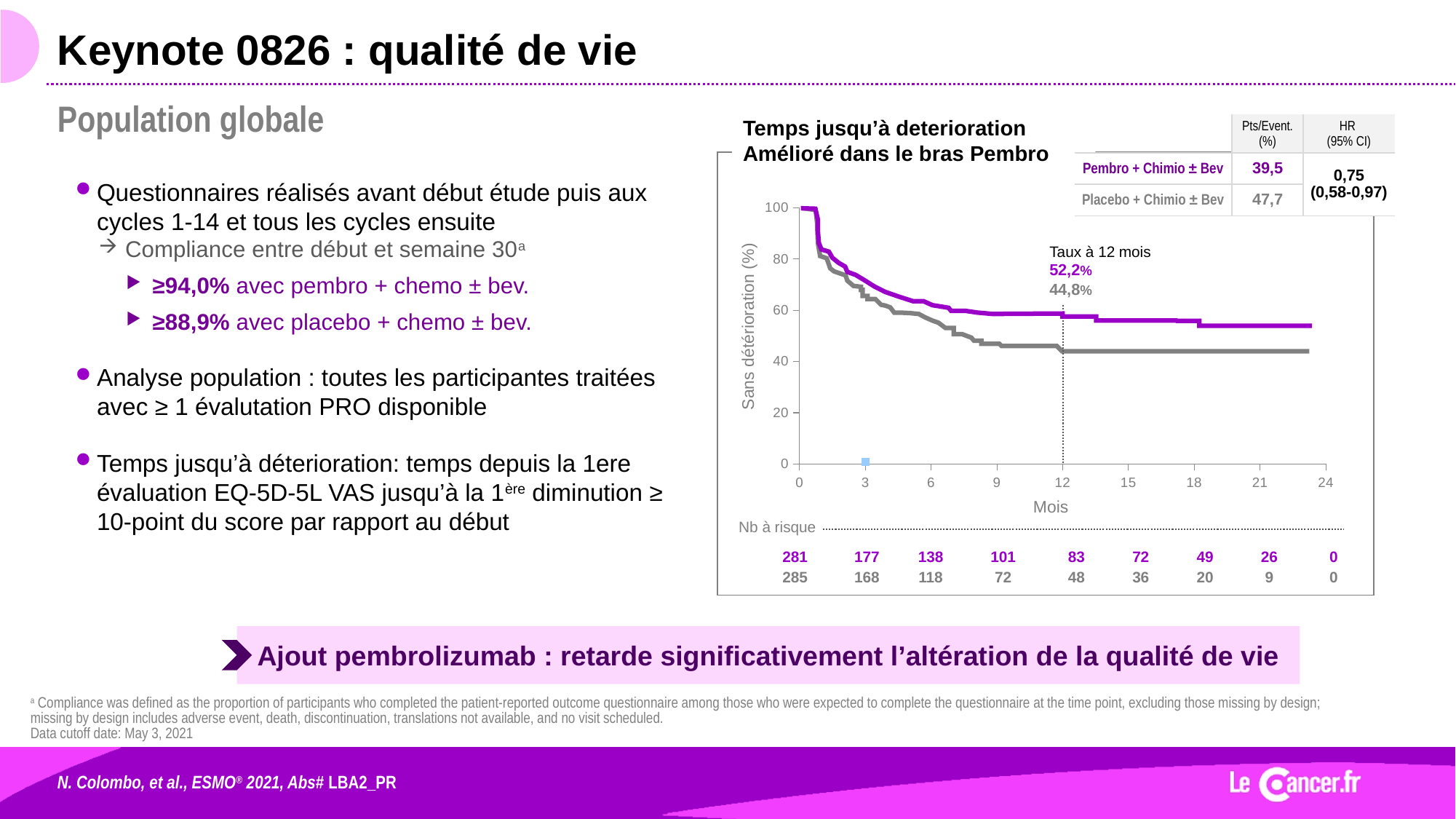
Do the curves rise or fall as time (Mois) increases? fall What is the HR (95% CI) shown in the table? 0,75 (0,58-0,97) How many patients were at risk in the Placebo + Chimio ± Bev arm at 0 months? 285 What is the rate at 12 months (Taux à 12 mois) for the Placebo + Chimio ± Bev arm? 44,8% Which arm has the higher rate at 12 months? Pembro + Chimio ± Bev Is the Placebo + Chimio ± Bev curve at 18 months greater or less than 60%? less How many patients were at risk in the Pembro + Chimio ± Bev arm at 9 months? 101 What is the difference between the 12-month rates of the Pembro and Placebo arms? 7,4% What is the rate at 12 months (Taux à 12 mois) for the Pembro + Chimio ± Bev arm? 52,2% What is the Pts/Event (%) value for the Placebo + Chimio ± Bev arm? 47,7 What kind of chart is shown on the slide? line chart What is the label of the y axis of the chart? Sans détérioration (%)